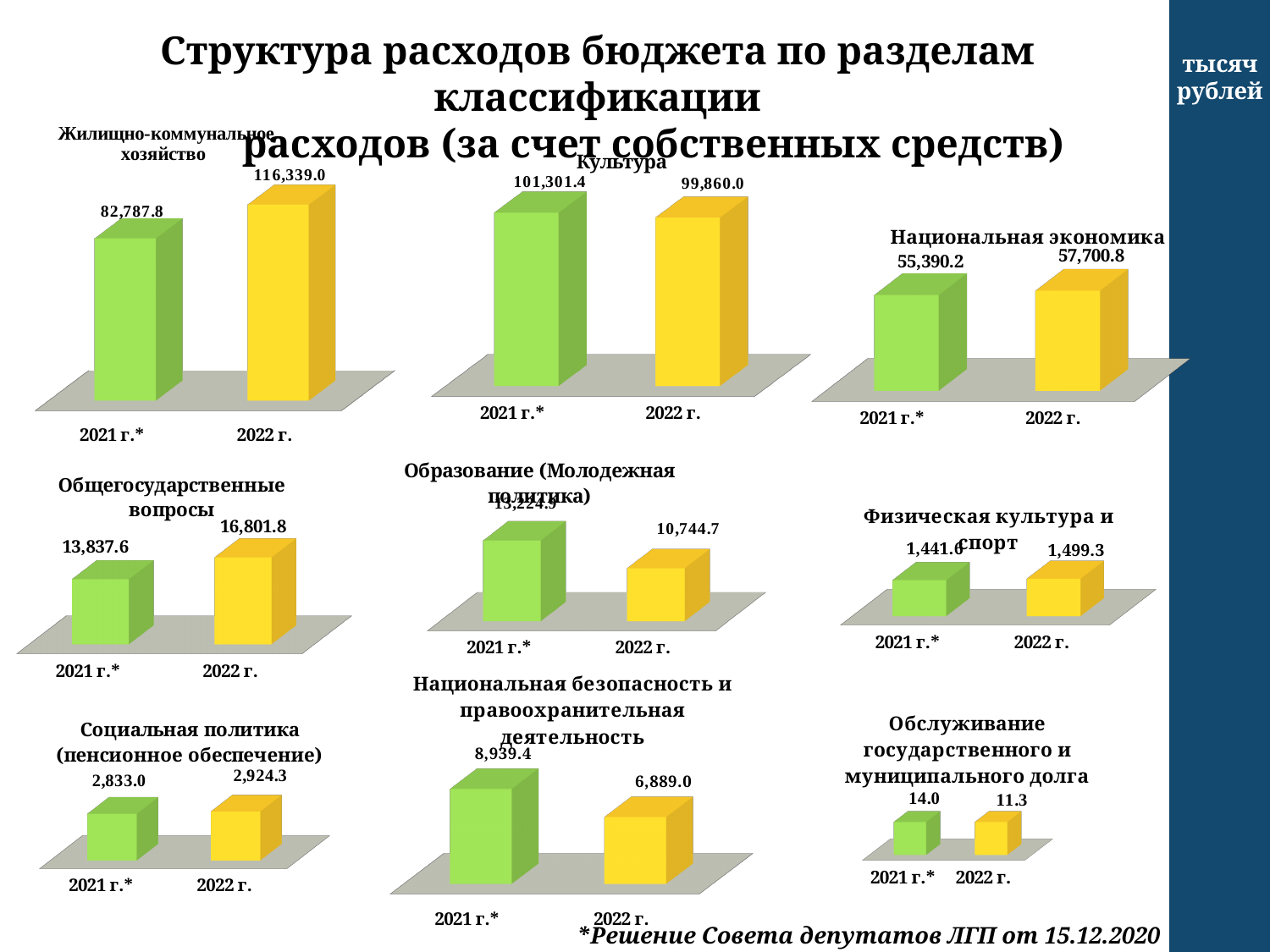
In the 'Жилищно-коммунальное хозяйство' chart, what is the value for 2022 г.? 116,339.0 In the 'Социальная политика (пенсионное обеспечение)' chart, what is the value for 2021 г.*? 2,833.0 In the 'Образование (Молодежная политика)' chart, what is the value for 2022 г.? 10,744.7 In the 'Обслуживание государственного и муниципального долга' chart, which year has the lowest value? 2022 г. In the 'Национальная экономика' chart, what is the value for 2021 г.*? 55,390.2 In the 'Физическая культура и спорт' chart, what is the difference between the 2022 г. and 2021 г.* values? 57.7 What kind of chart is the 'Национальная экономика' chart? bar chart In the 'Жилищно-коммунальное хозяйство' chart, what is the difference between the 2022 г. and 2021 г.* values? 33,551.2 In the 'Общегосударственные вопросы' chart, what is the value for 2022 г.? 16,801.8 In the 'Культура' chart, which year has the higher value, 2021 г.* or 2022 г.? 2021 г.* In the 'Национальная безопасность и правоохранительная деятельность' chart, do the values rise or fall from 2021 г.* to 2022 г.? fall How many bars does the 'Культура' chart show? 2